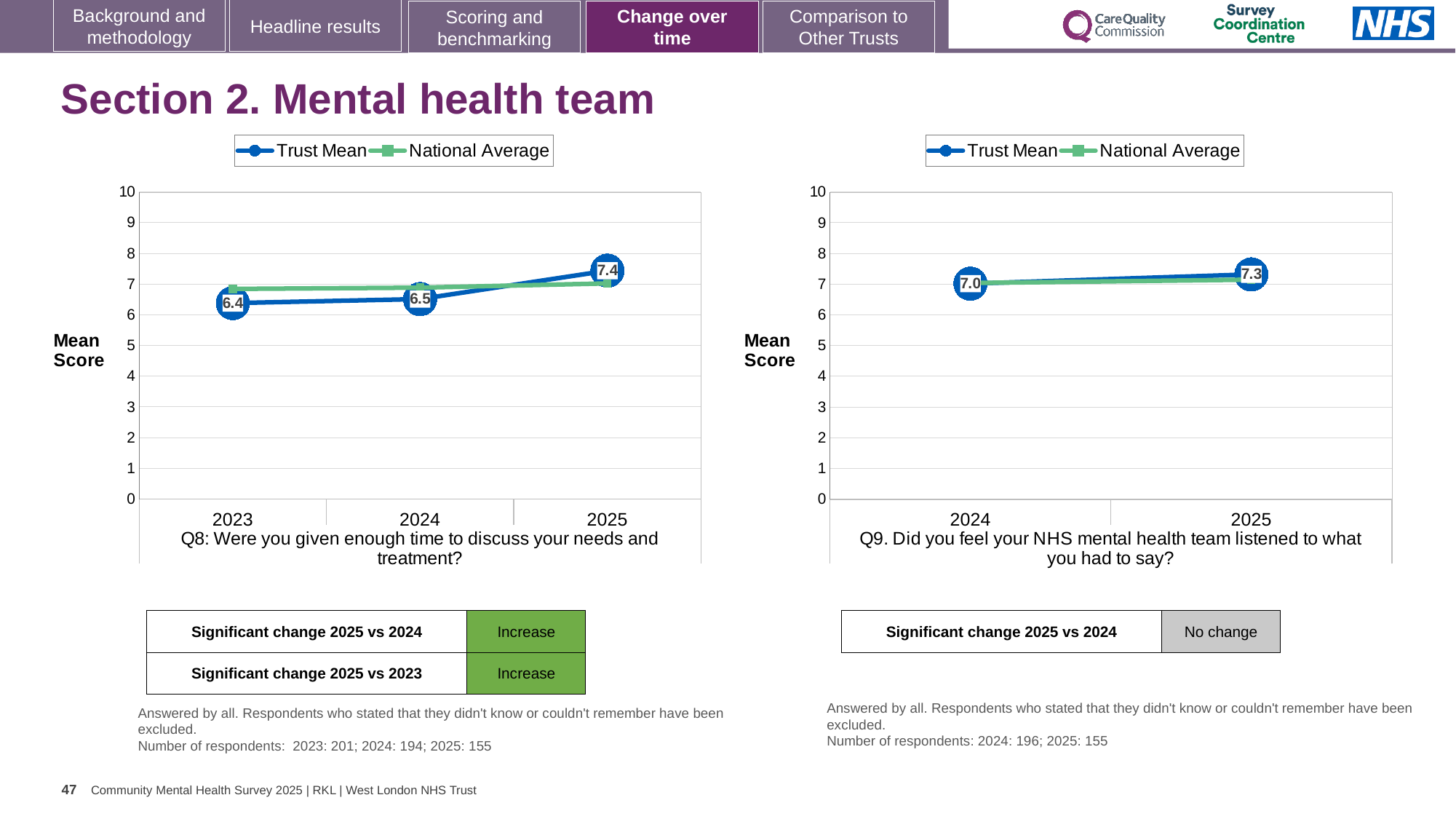
On the Q9 chart, is the National Average for 2025 greater or less than 8? less How many series does the legend of the Q8 chart list? 2 What kind of chart is the Q8 chart? Line chart On the Q8 chart, what is the difference between the Trust Mean in 2025 and in 2024? 0.9 On the Q8 chart, is the Trust Mean for 2023 greater or less than the National Average for 2023? less On the Q9 chart, what is the Trust Mean for 2024? 7.0 How many years are shown on the x axis of the Q9 chart? 2 On the Q8 chart, what is the Trust Mean for 2023? 6.4 On the Q9 chart, what is the difference between the Trust Mean in 2025 and in 2024? 0.3 On the Q8 chart, what is the Trust Mean for 2025? 7.4 On the Q8 chart, which year has the lowest Trust Mean? 2023 On the Q8 chart, which year has the highest Trust Mean? 2025